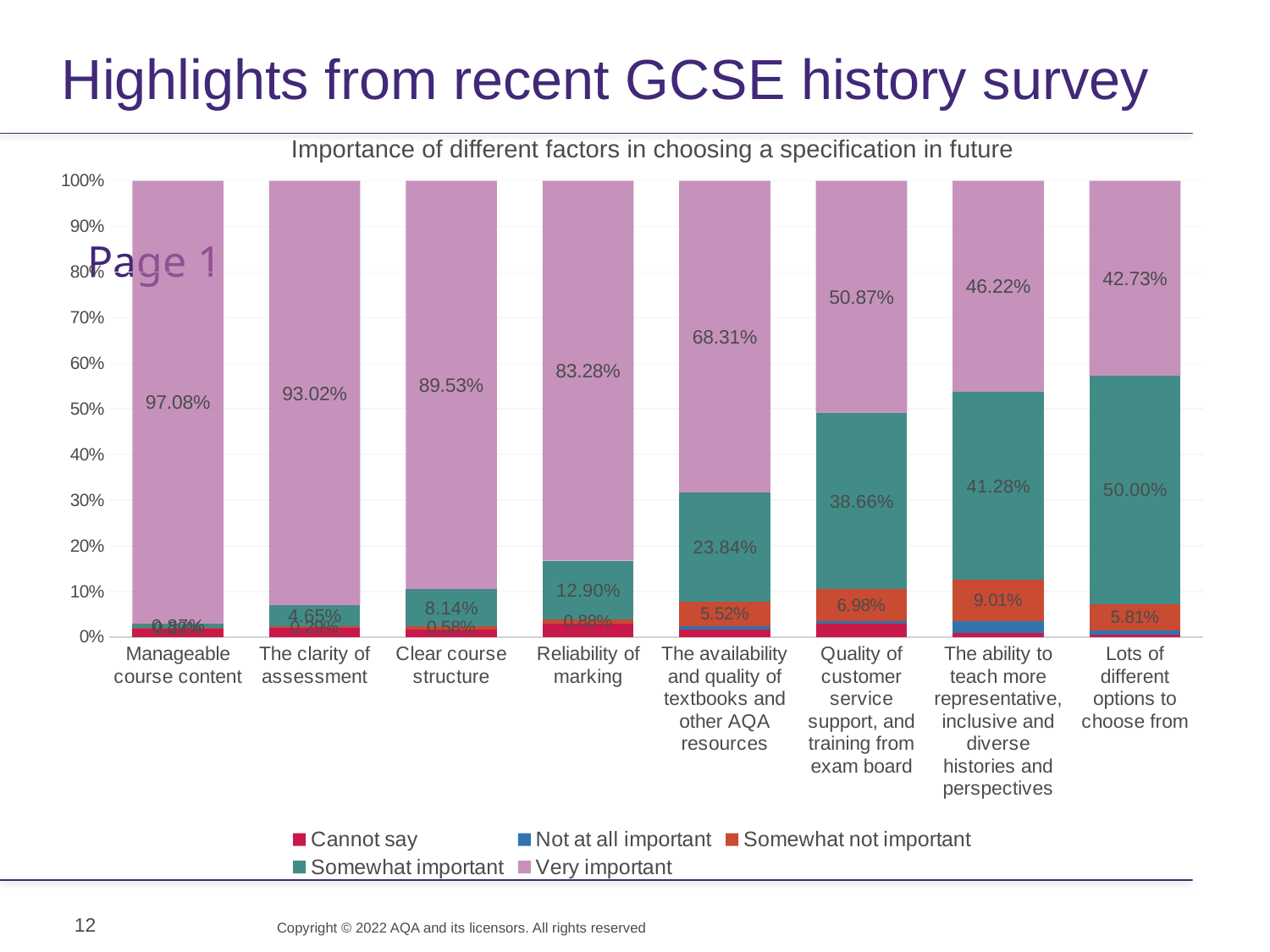
Does the Very important percentage rise or fall moving from left to right across the factors? Fall How many factors (categories) are plotted along the x axis? 8 What is the Somewhat important value for 'Lots of different options to choose from'? 50.00% What is the Somewhat important value for 'Reliability of marking'? 12.90% Which factor has the lowest Very important percentage? Lots of different options to choose from What kind of chart is shown on the slide? Stacked bar chart What percentage rated 'Manageable course content' as Very important? 97.08% How many series does the legend list? 5 What is the difference between the Very important values for 'Manageable course content' and 'Lots of different options to choose from'? 54.35% For 'Quality of customer service support, and training from exam board', which is larger: the Very important share or the Somewhat important share? Very important Which factor has the highest Very important percentage? Manageable course content What is the Somewhat not important value for 'The ability to teach more representative, inclusive and diverse histories and perspectives'? 9.01%